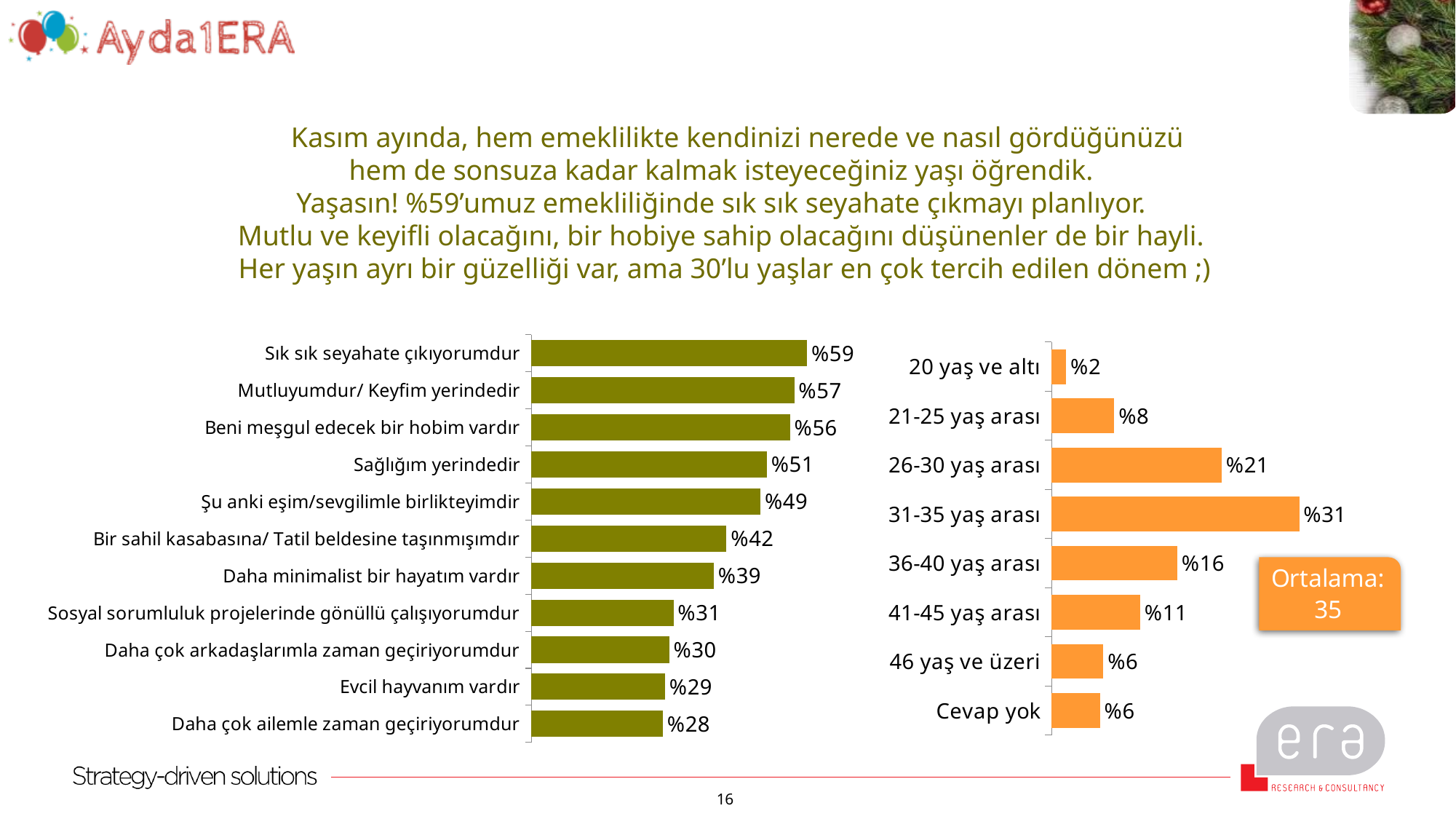
In the left chart, which category has the lowest value? Daha çok ailemle zaman geçiriyorumdur In the left chart, how many categories are shown? 11 In the right chart, what is the value for "26-30 yaş arası"? %21 In the right chart, what is the difference between "31-35 yaş arası" and "21-25 yaş arası"? %23 In the right chart, which age group has the highest value? 31-35 yaş arası In the right chart, how many categories are shown? 8 In the left chart, what is the value for "Daha minimalist bir hayatım vardır"? %39 What type of chart is the right chart? Bar chart In the left chart, what is the difference between "Sağlığım yerindedir" and "Evcil hayvanım vardır"? %22 In the right chart, which is larger: "36-40 yaş arası" or "41-45 yaş arası"? 36-40 yaş arası In the left chart, what is the value for "Sık sık seyahate çıkıyorumdur"? %59 In the right chart, which age group has the lowest value? 20 yaş ve altı